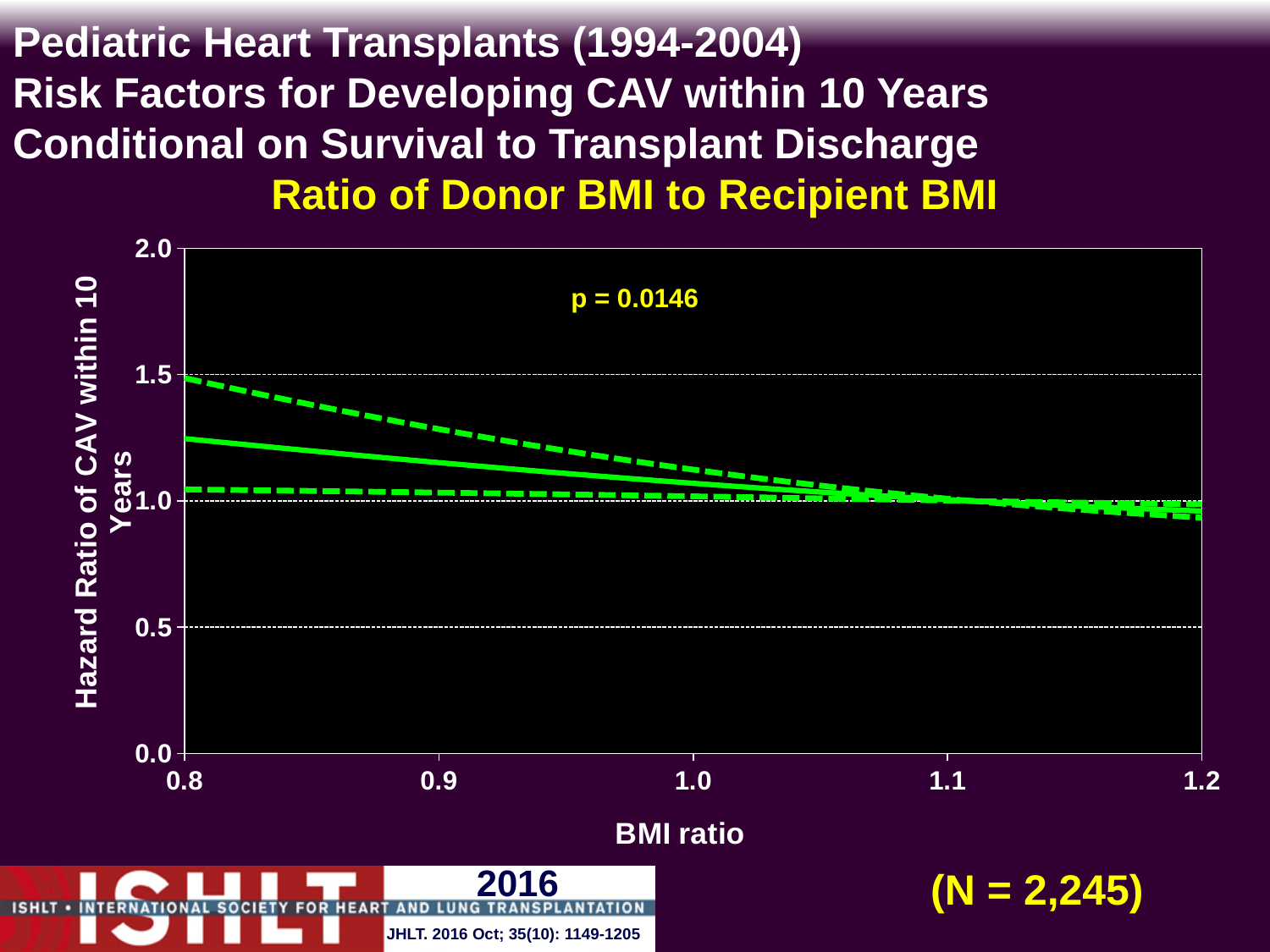
How many lines are plotted on the chart? 3 Does the solid hazard ratio line rise or fall as the BMI ratio increases from 0.8 to 1.2? fall What is the label of the x axis? BMI ratio What p-value is printed on the chart? p = 0.0146 Is the value of the solid hazard ratio line at a BMI ratio of 0.8 greater or less than 1.0? greater Is the value of the upper dashed line at a BMI ratio of 1.0 greater or less than 1.5? less Is the value of the solid hazard ratio line at a BMI ratio of 0.8 greater or less than 1.5? less What sample size (N) is shown on the slide? N = 2,245 What kind of chart is shown on the slide? line chart What is the chart's subtitle shown in yellow? Ratio of Donor BMI to Recipient BMI